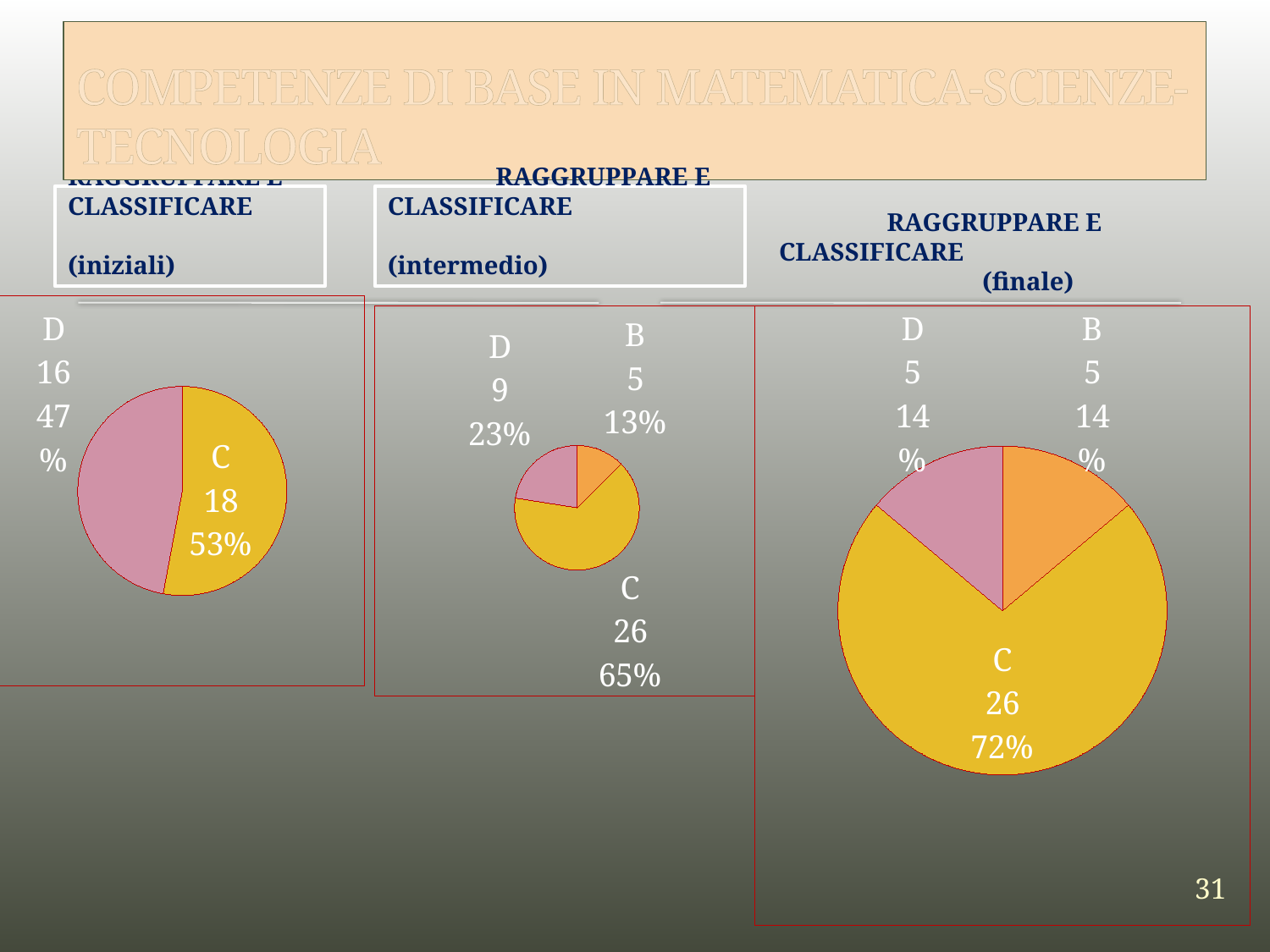
In the (intermedio) pie chart, what share does B have? 13% In the (finale) pie chart, what is the difference between the values for C and D? 21 How many slices does the (finale) pie chart have? 3 In the (iniziali) pie chart, which is larger, C or D? C In the (iniziali) pie chart, what share does D have? 47% In the (intermedio) pie chart, what is the value for D? 9 In the (intermedio) pie chart, which category is the largest? C In the (intermedio) pie chart, which category is the smallest? B In the (finale) pie chart, what share does C have? 72% In the (iniziali) pie chart, what is the value for C? 18 In the (finale) pie chart, what is the value for B? 5 What kind of chart is used for the (intermedio) data? pie chart